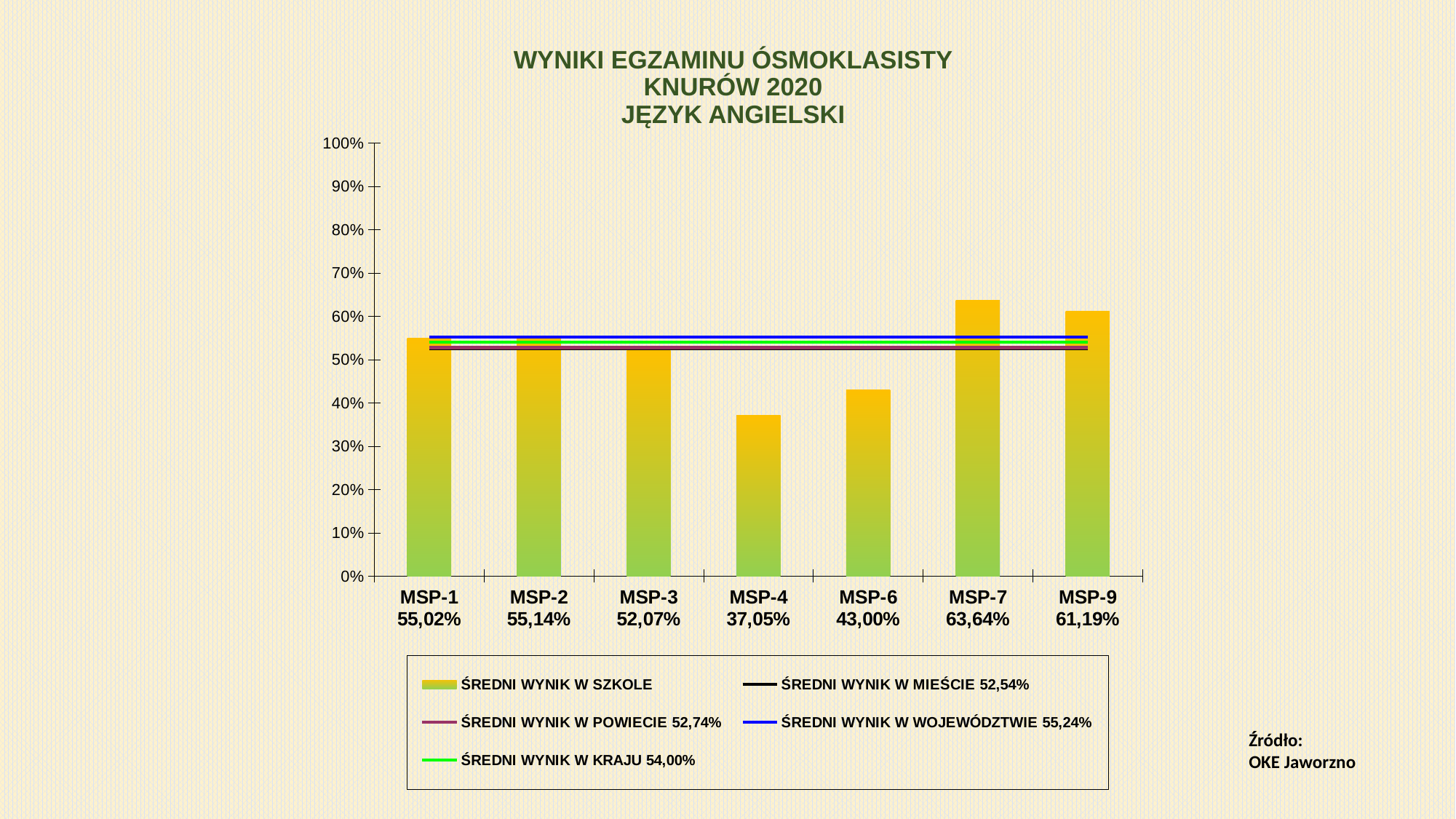
What is the difference between the results of MSP-9 and MSP-6? 18,19% What is the average school result (ŚREDNI WYNIK W SZKOLE) for MSP-7? 63,64% How many series does the legend list? 5 Which school has the highest average result? MSP-7 Which school has the lowest average result? MSP-4 How many schools are shown on the x axis? 7 What is the average school result for MSP-4? 37,05% What is the average result in the voivodeship (ŚREDNI WYNIK W WOJEWÓDZTWIE) shown in the legend? 55,24% What kind of chart is shown on the slide? combination bar and line chart What is the difference between the results of MSP-7 and MSP-4? 26,59% Is the value for MSP-6 greater or less than 50%? less Which school has the larger result, MSP-3 or MSP-6? MSP-3